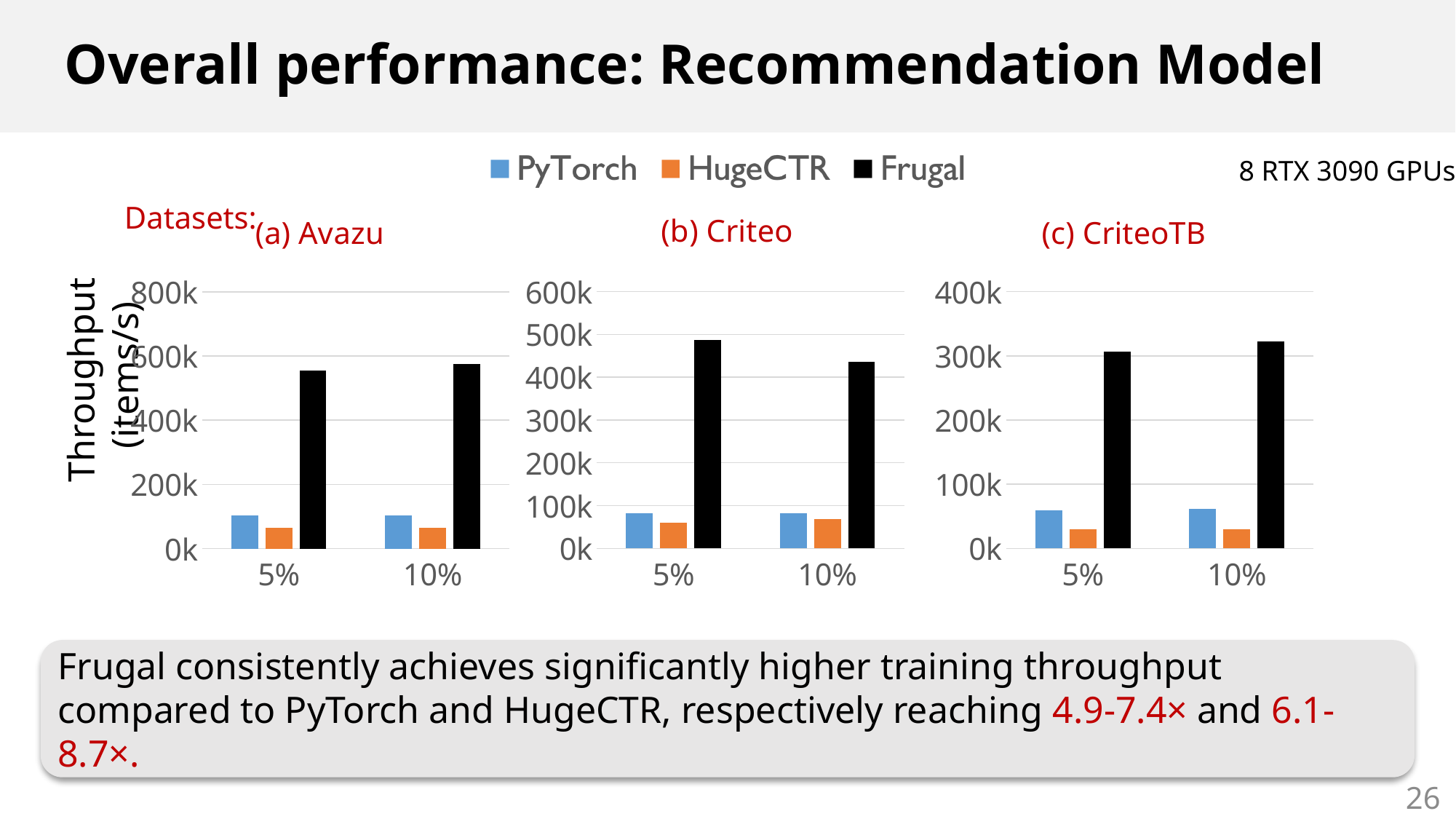
In the (b) Criteo chart, how many categories are shown on the x axis? 2 In the (b) Criteo chart, is the Frugal bar at 5% greater or less than 400k? greater In the (c) CriteoTB chart, which series has the lowest throughput at 10%? HugeCTR In the (b) Criteo chart, does the Frugal throughput rise or fall from 5% to 10%? fall What kind of chart is used for the (a) Avazu panel? bar chart What is the y-axis label shared by the charts? Throughput (items/s) In the (b) Criteo chart, which is larger for Frugal: the 5% bar or the 10% bar? 5% In the (a) Avazu chart, is the PyTorch bar at 5% greater or less than 200k? less In the (a) Avazu chart, which series has the highest throughput at 5%? Frugal In the (c) CriteoTB chart, is the Frugal bar at 5% greater or less than 200k? greater How many series does the legend list? 3 What colour represents Frugal in the legend? black